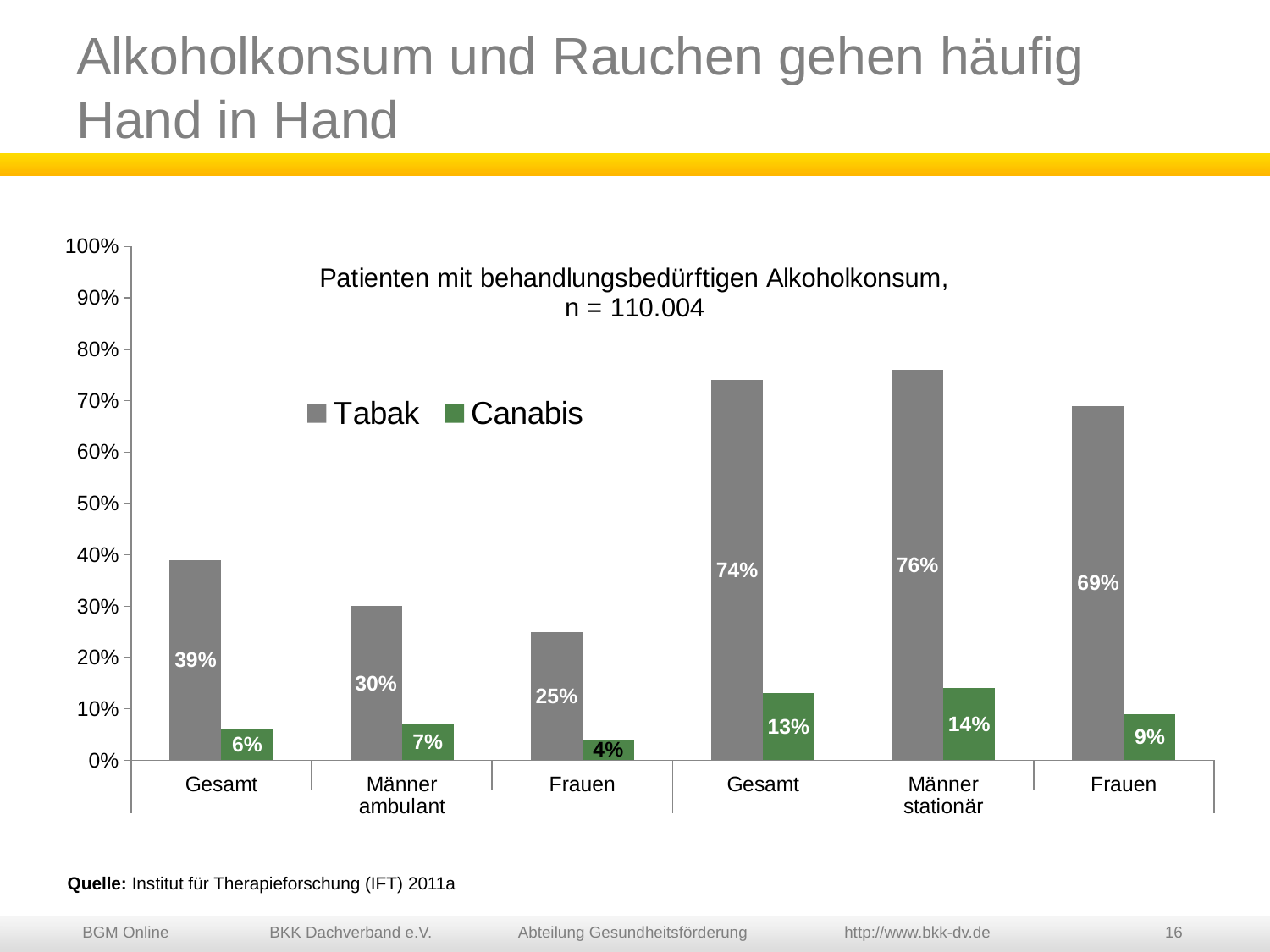
What sample size (n) is stated in the chart title? n = 110.004 What is the Tabak value for Männer in the stationär group? 76% Which is larger, the Canabis value for Männer ambulant or for Frauen ambulant? Männer ambulant Which category has the highest Tabak value? Männer (stationär) Is the Tabak value for Frauen in the stationär group greater or less than 60%? greater What is the Tabak value for Gesamt in the ambulant group? 39% What is the Canabis value for Frauen in the stationär group? 9% What is the difference between the Tabak values for Gesamt stationär and Gesamt ambulant? 35% What kind of chart is shown on the slide? bar chart Which category has the lowest Canabis value? Frauen (ambulant) How many series does the legend list? 2 How many categories are shown on the x axis? 6